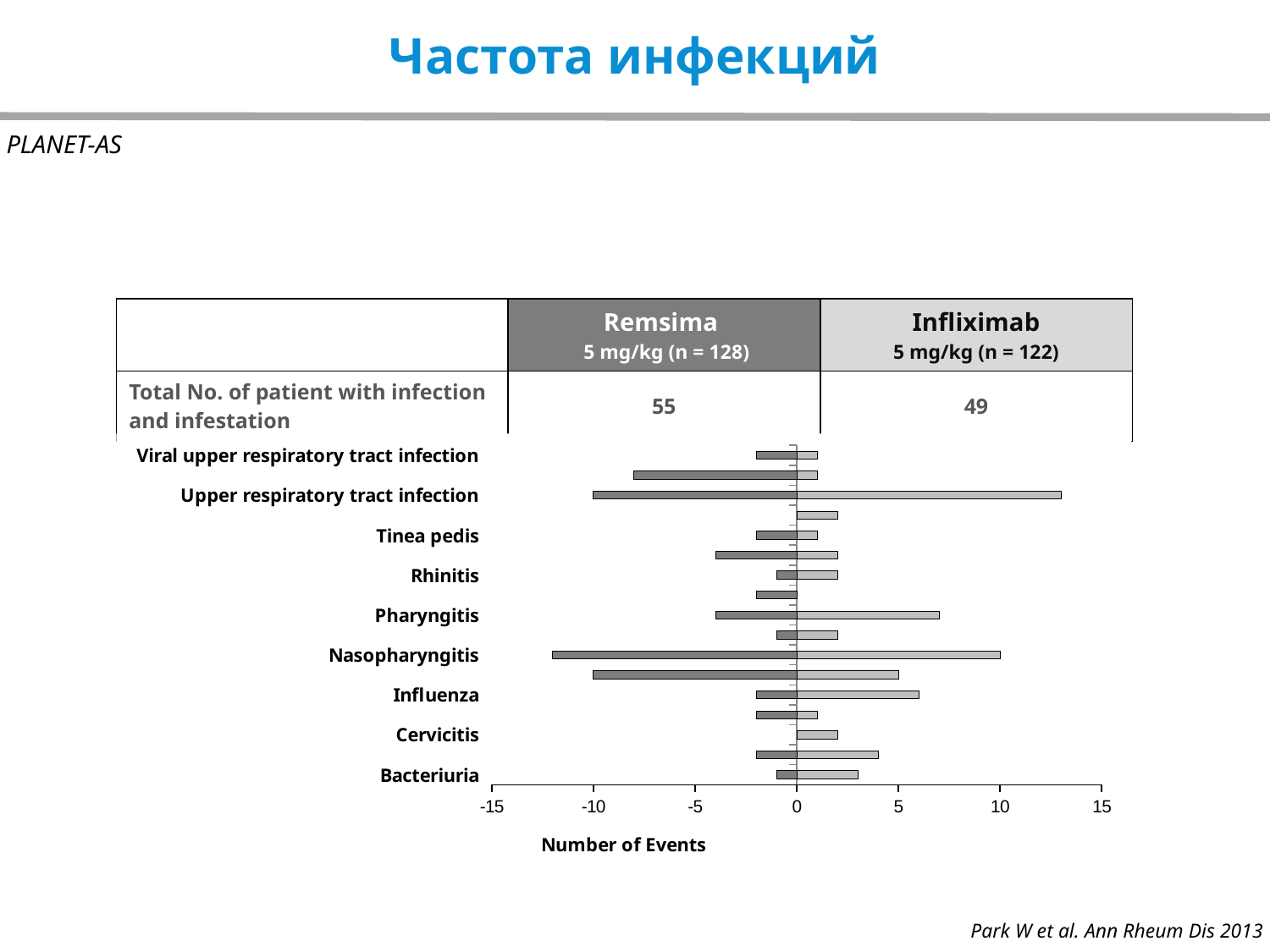
How many infection categories are labelled on the y axis of the chart? 9 What is the total number of patients with infection and infestation in the Remsima group? 55 Which infection category has the longest Infliximab bar in the chart? Upper respiratory tract infection Which group has more patients with infection and infestation, Remsima or Infliximab? Remsima What is the total number of patients with infection and infestation in the Infliximab group? 49 Which infection category has the longest Remsima bar in the chart? Nasopharyngitis What kind of chart is shown on the slide? bar chart How many treatment groups are compared in the chart? 2 Which treatment group is plotted with dark bars on the negative (left) side of the chart? Remsima Is the number of events for the longest Infliximab bar greater or less than 10? greater What is the difference between the total number of patients with infection and infestation in the Remsima group and in the Infliximab group? 6 What is the title of the x axis of the chart? Number of Events